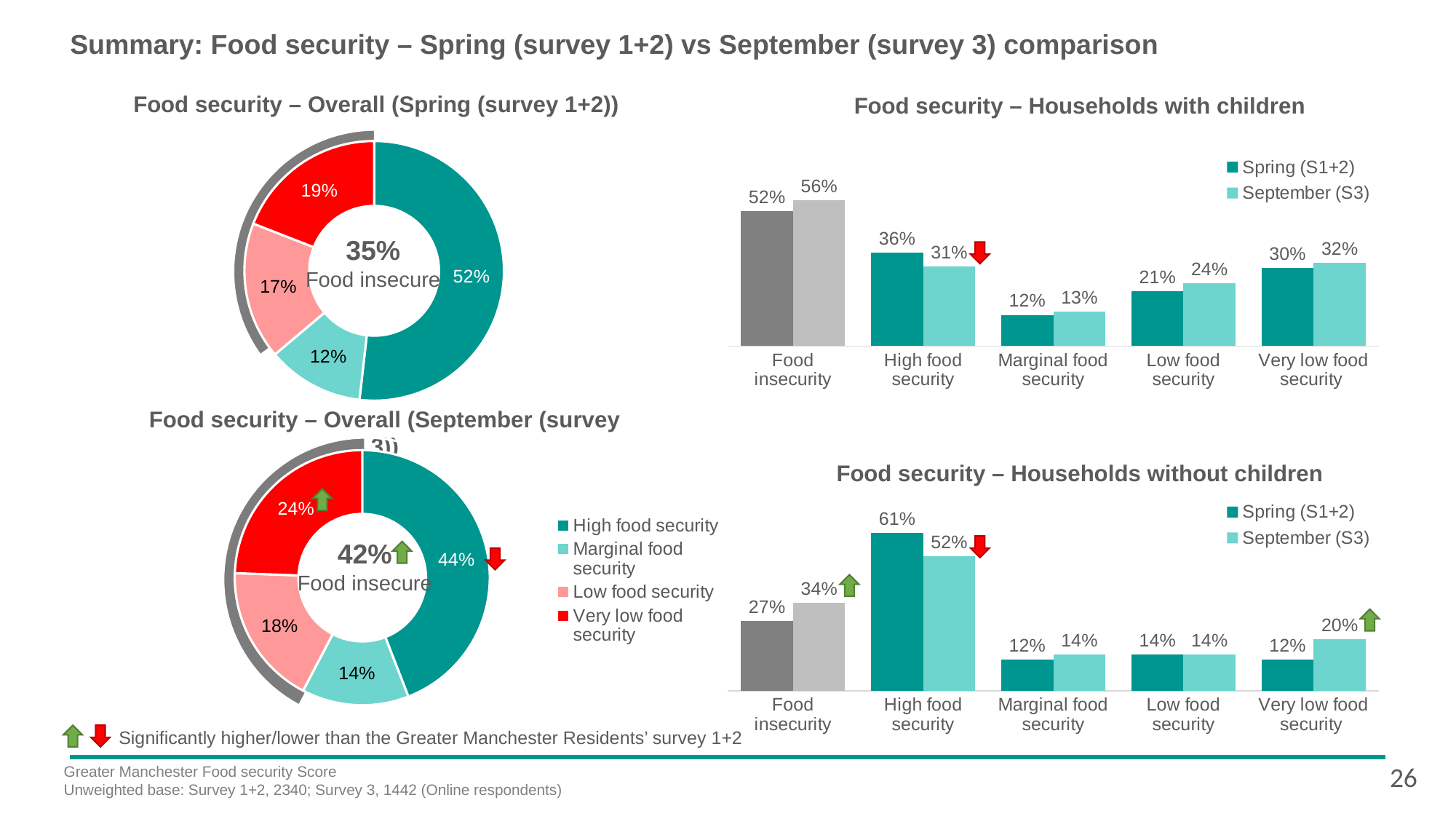
In the 'Food security – Households without children' chart, which category has the highest September (S3) value? High food security In the 'Food security – Overall (Spring (survey 1+2))' donut chart, which category has the smallest share? Marginal food security In the 'Food security – Households without children' chart, what is the Spring (S1+2) value for High food security? 61% How many series does the legend of the 'Food security – Households with children' chart list? 2 In the 'Food security – Overall (Spring (survey 1+2))' donut chart, what share is High food security? 52% How many categories are shown on the x axis of the 'Food security – Households without children' chart? 5 In the 'Food security – Overall (September (survey 3))' donut chart, what share is Very low food security? 24% What kind of chart is 'Food security – Households with children'? Bar chart In the 'Food security – Overall (September (survey 3))' donut chart, what percentage is shown in the centre as food insecure? 42% In the 'Food security – Households without children' chart, is the Spring (S1+2) value for Food insecurity larger or smaller than the September (S3) value? smaller In the 'Food security – Households with children' chart, what is the September (S3) value for Low food security? 24% In the 'Food security – Households with children' chart, what is the difference between the Spring (S1+2) and September (S3) values for High food security? 5%